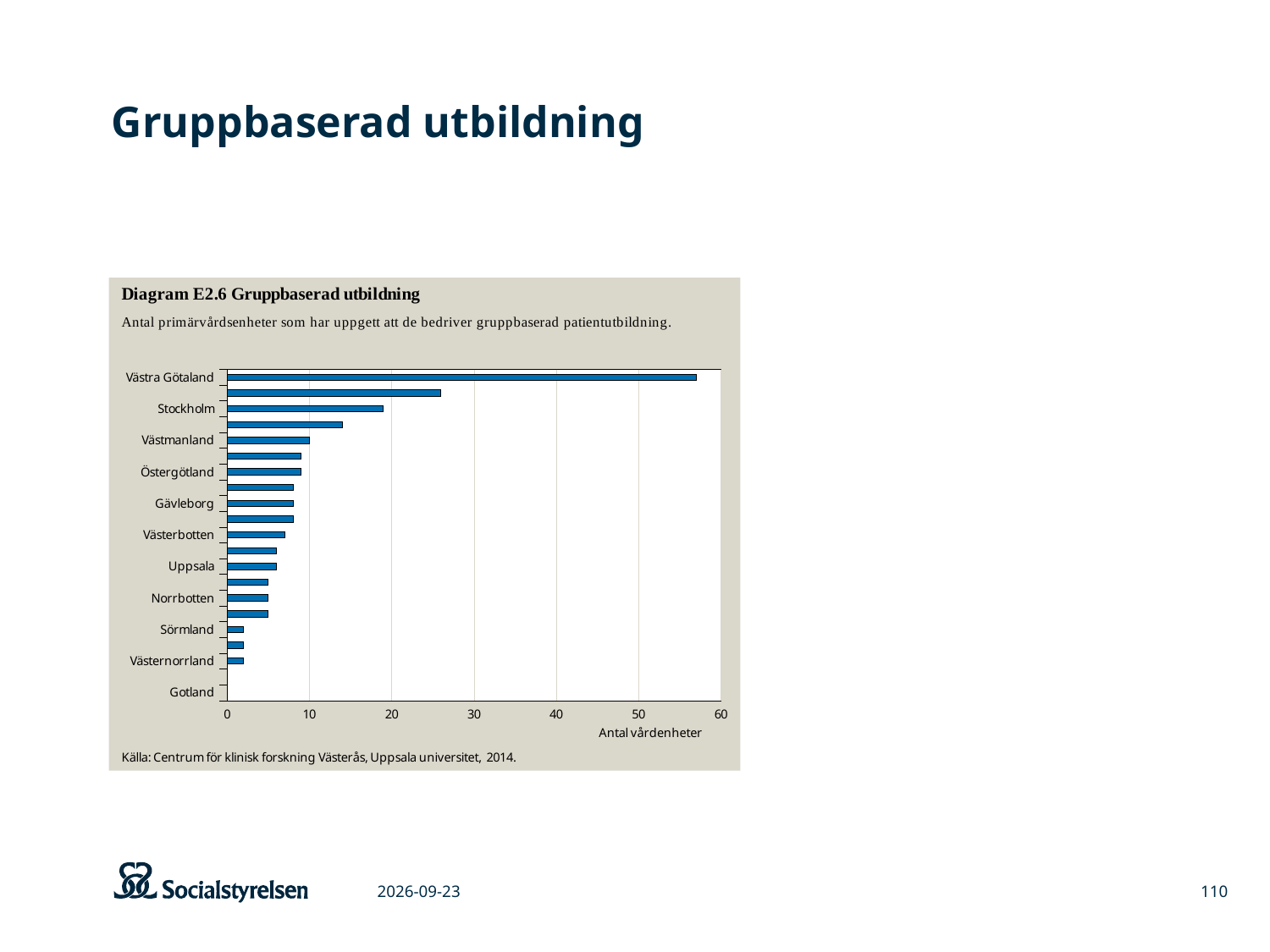
Which has a larger value, Stockholm or Uppsala? Stockholm Do the bar values increase or decrease going from the top of the chart to the bottom? decrease Is the value for Stockholm greater or less than 20? less What is the value for Gotland? 0 Which region has the highest number of care units with group-based patient education? Västra Götaland What kind of chart is shown on the slide? bar chart Which has a larger value, Västmanland or Norrbotten? Västmanland Is the value for Västra Götaland greater or less than 50? greater Is the value for Gävleborg greater or less than 10? less What is the label on the horizontal axis of the chart? Antal vårdenheter Which labelled region has the lowest value in the chart? Gotland